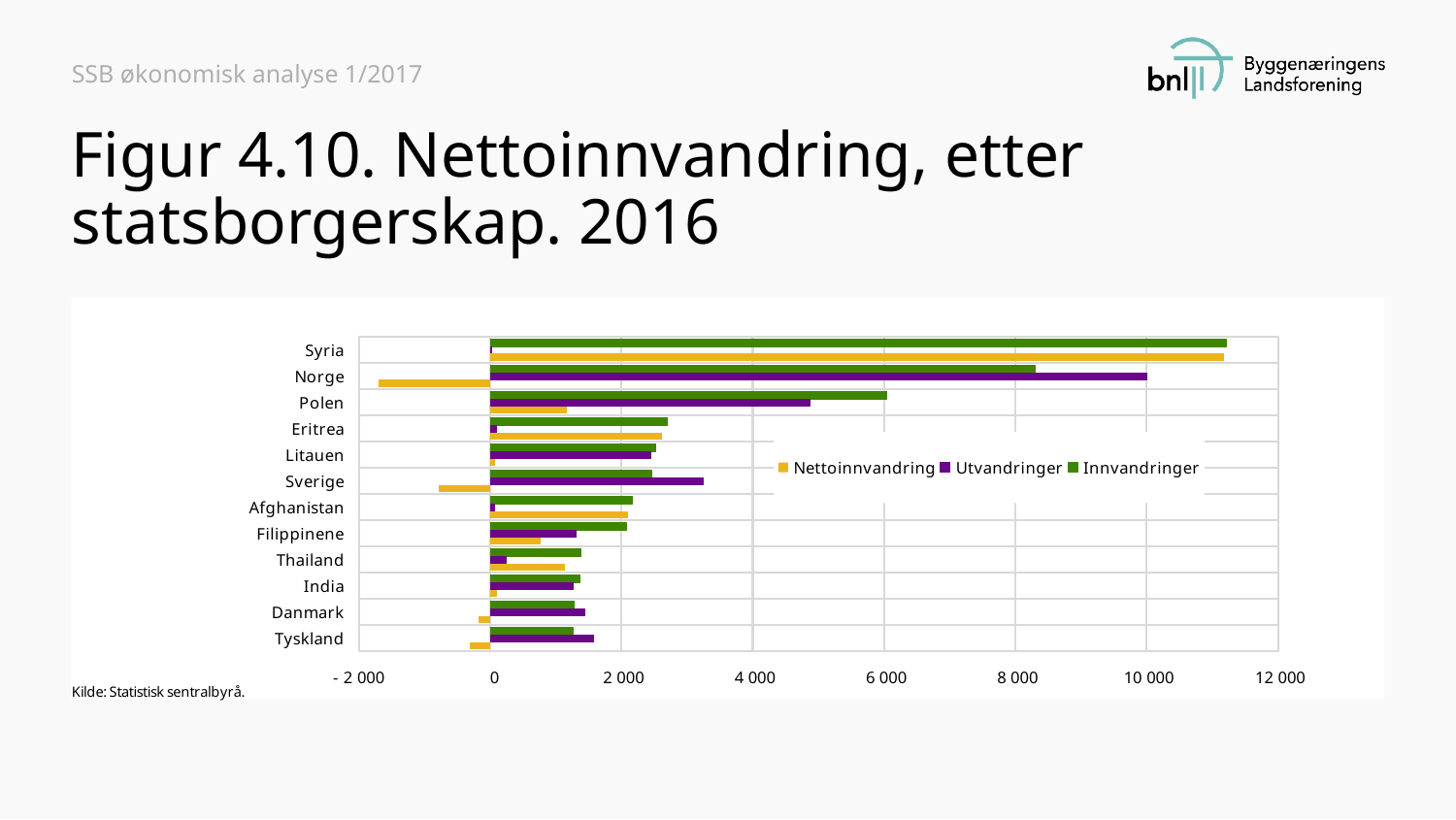
Which colour represents the Nettoinnvandring series in the legend? Yellow How many series does the chart legend list? 3 How many countries are listed on the vertical axis of the chart? 12 Is the Nettoinnvandring value for Sverige greater or less than 0? less Which country has the highest Innvandringer value? Syria Is the Innvandringer value for Syria greater or less than 10 000? greater Which is larger: the Utvandringer value for Sverige or the Utvandringer value for Eritrea? Sverige Which country has the lowest Nettoinnvandring value? Norge Which country has the highest Utvandringer value? Norge What kind of chart is shown on the slide? Bar chart Is the Utvandringer value for Polen greater or less than 4 000? greater Which is larger: the Innvandringer value for Syria or the Innvandringer value for Norge? Syria